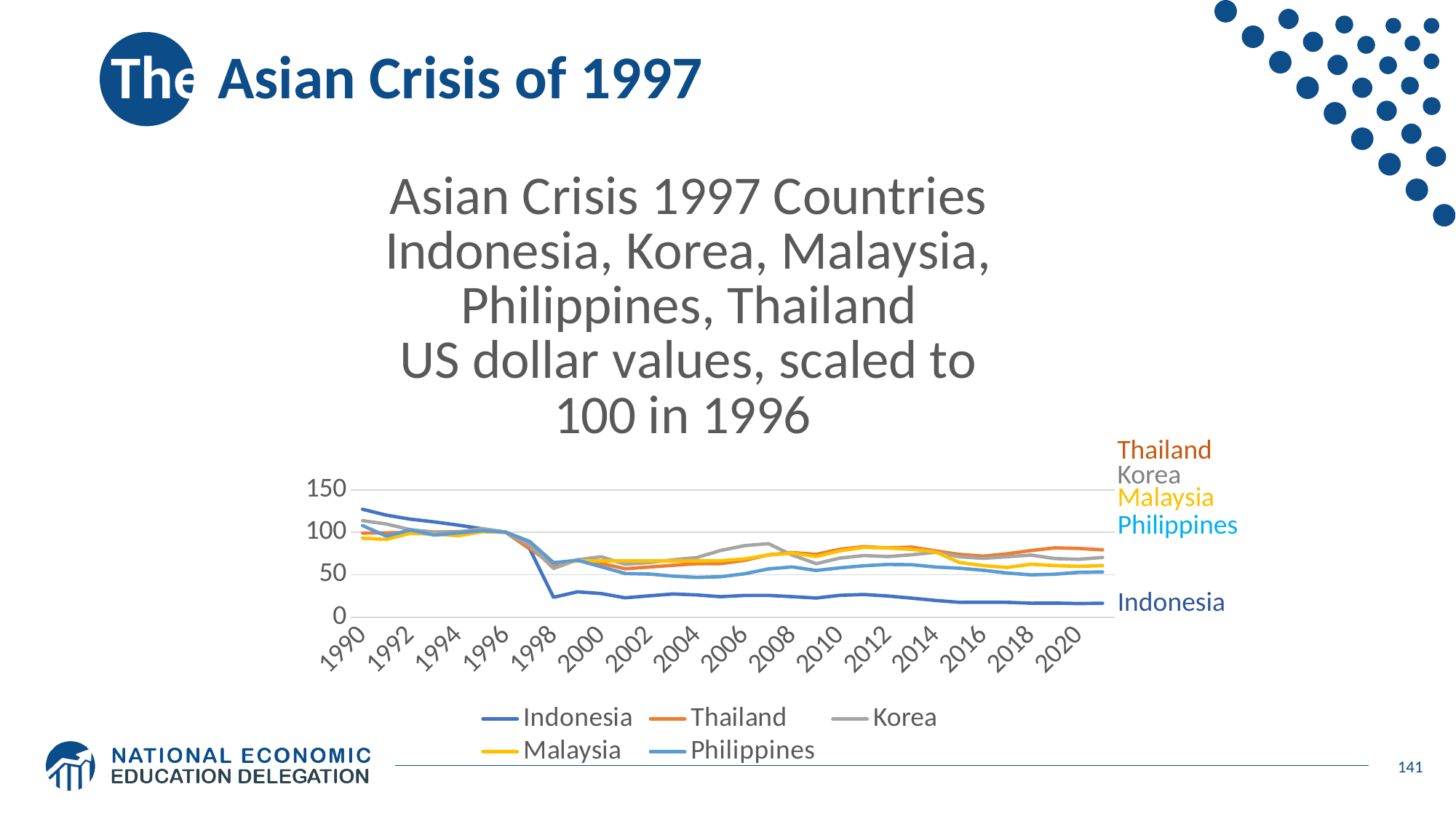
Which countries are listed in the chart legend? Indonesia, Thailand, Korea, Malaysia, Philippines In 2020, which is larger: the value for Thailand or the value for Indonesia? Thailand What kind of chart is shown on the slide? line chart Which country has the highest value in 1990? Indonesia Does the value for Indonesia rise or fall from 1990 to 2020? fall How many series does the legend list? 5 Is the value for Korea in 2008 greater or less than 50? greater What is the value for Indonesia in 1996? 100 Is the value for Indonesia in 2020 greater or less than 50? less Is the value for Thailand in 2020 greater or less than 50? greater Which country has the lowest value in 2020? Indonesia